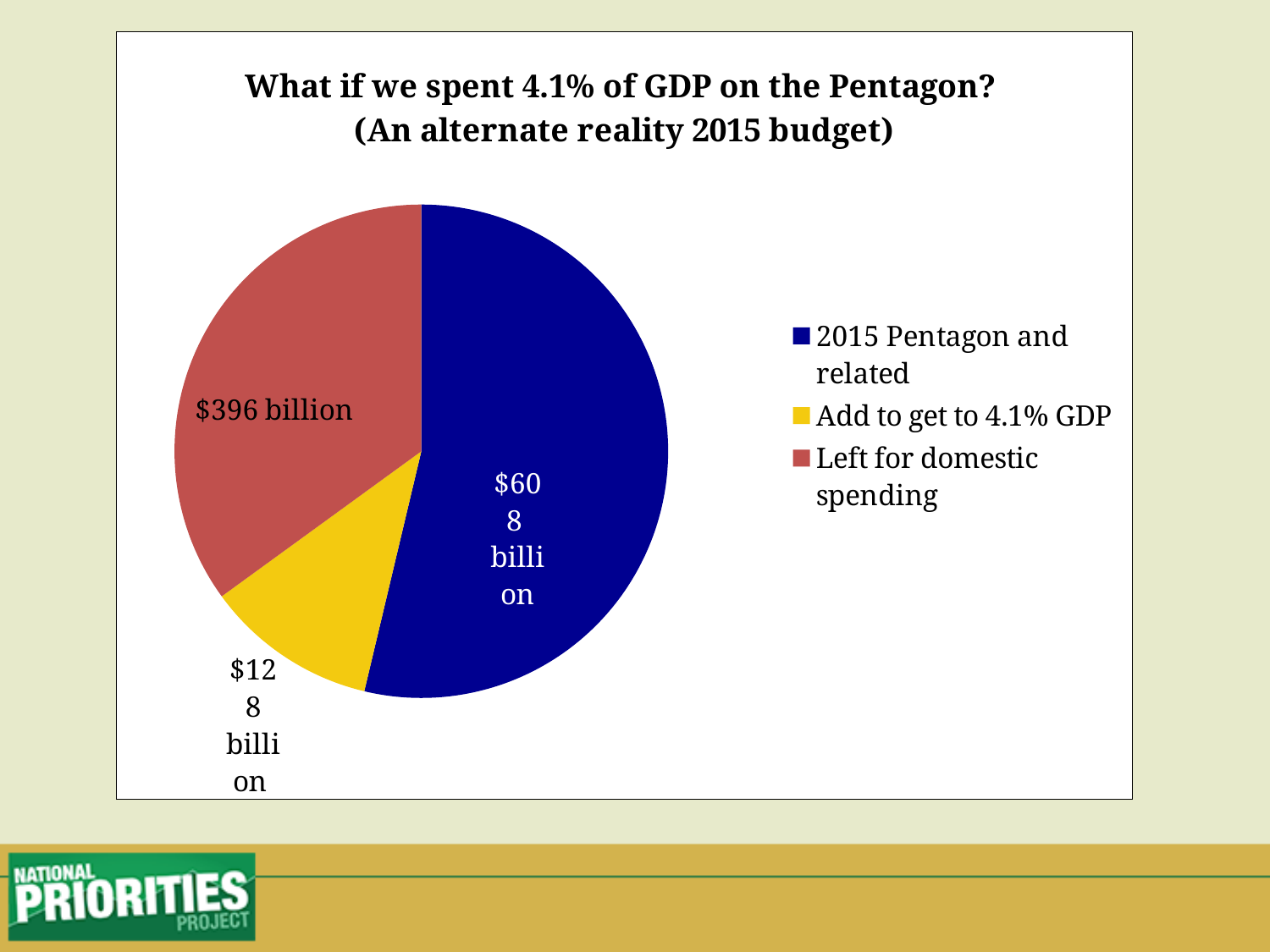
Which slice of the pie is the smallest? Add to get to 4.1% GDP What is the total of all three slices in the pie chart? $1,132 billion Which slice of the pie is the largest? 2015 Pentagon and related What type of chart is shown on the slide? Pie chart What value is shown for the 'Left for domestic spending' slice? $396 billion Which is larger: 'Left for domestic spending' or 'Add to get to 4.1% GDP'? Left for domestic spending What is the difference between the 'Left for domestic spending' value and the 'Add to get to 4.1% GDP' value? $268 billion How many slices does the pie chart have? 3 What value is shown for the 'Add to get to 4.1% GDP' slice? $128 billion What value is shown for the '2015 Pentagon and related' slice? $608 billion What colour is the 'Left for domestic spending' slice? Red What is the difference between the '2015 Pentagon and related' value and the 'Left for domestic spending' value? $212 billion